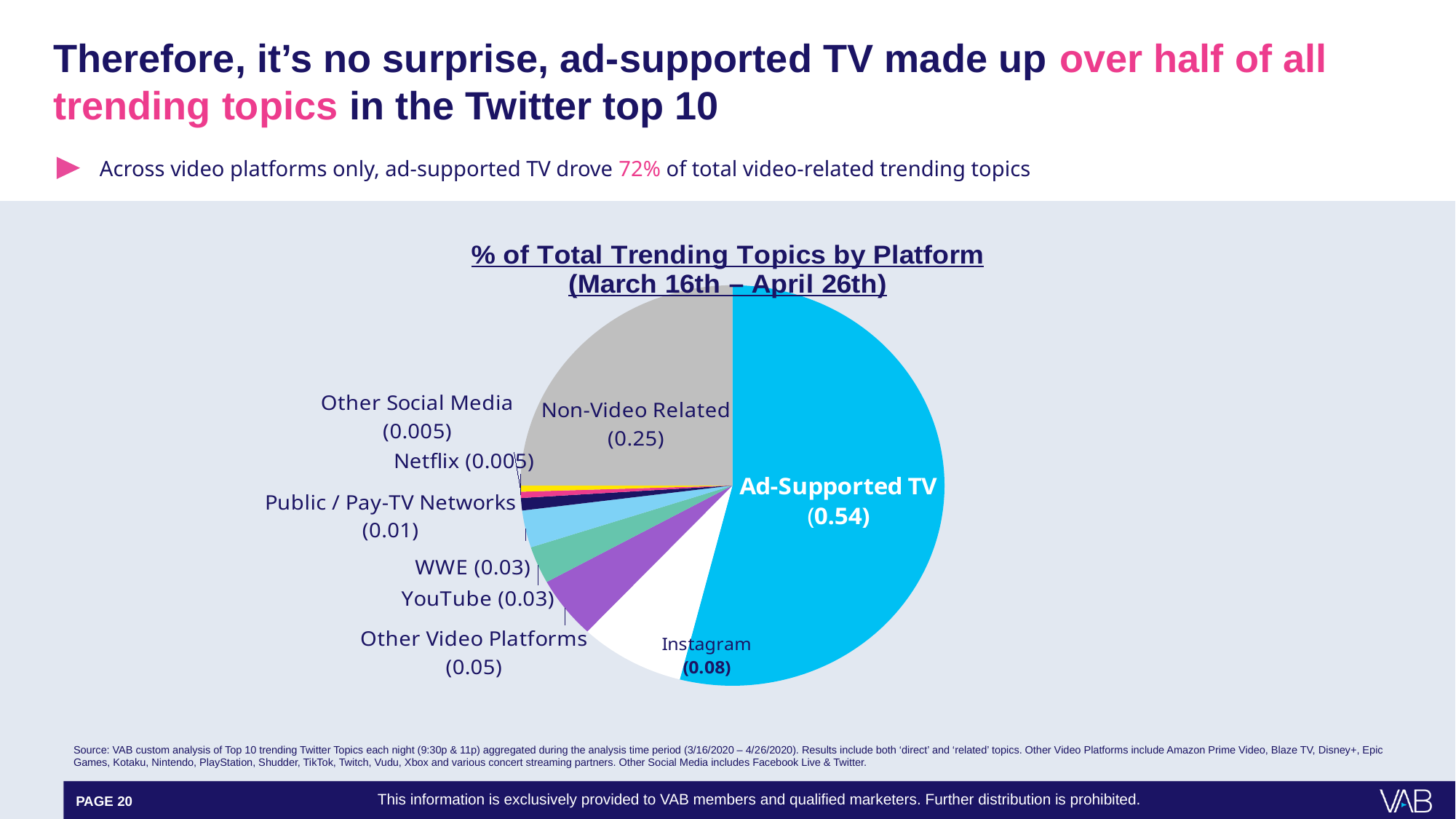
What is the title of the chart? % of Total Trending Topics by Platform (March 16th – April 26th) What is the value shown for Public / Pay-TV Networks? 0.01 Which platform has the largest slice of the pie? Ad-Supported TV Which is larger, the value for Instagram or the value for Other Video Platforms? Instagram What is the value shown for Non-Video Related? 0.25 What is the value shown for Other Video Platforms? 0.05 What value is shown for Netflix? 0.005 What kind of chart is shown on the slide? Pie chart What is the value shown for Instagram? 0.08 What is the difference between the values for Ad-Supported TV and Non-Video Related? 0.29 How many slices does the pie chart have? 9 What is the value shown for Ad-Supported TV? 0.54